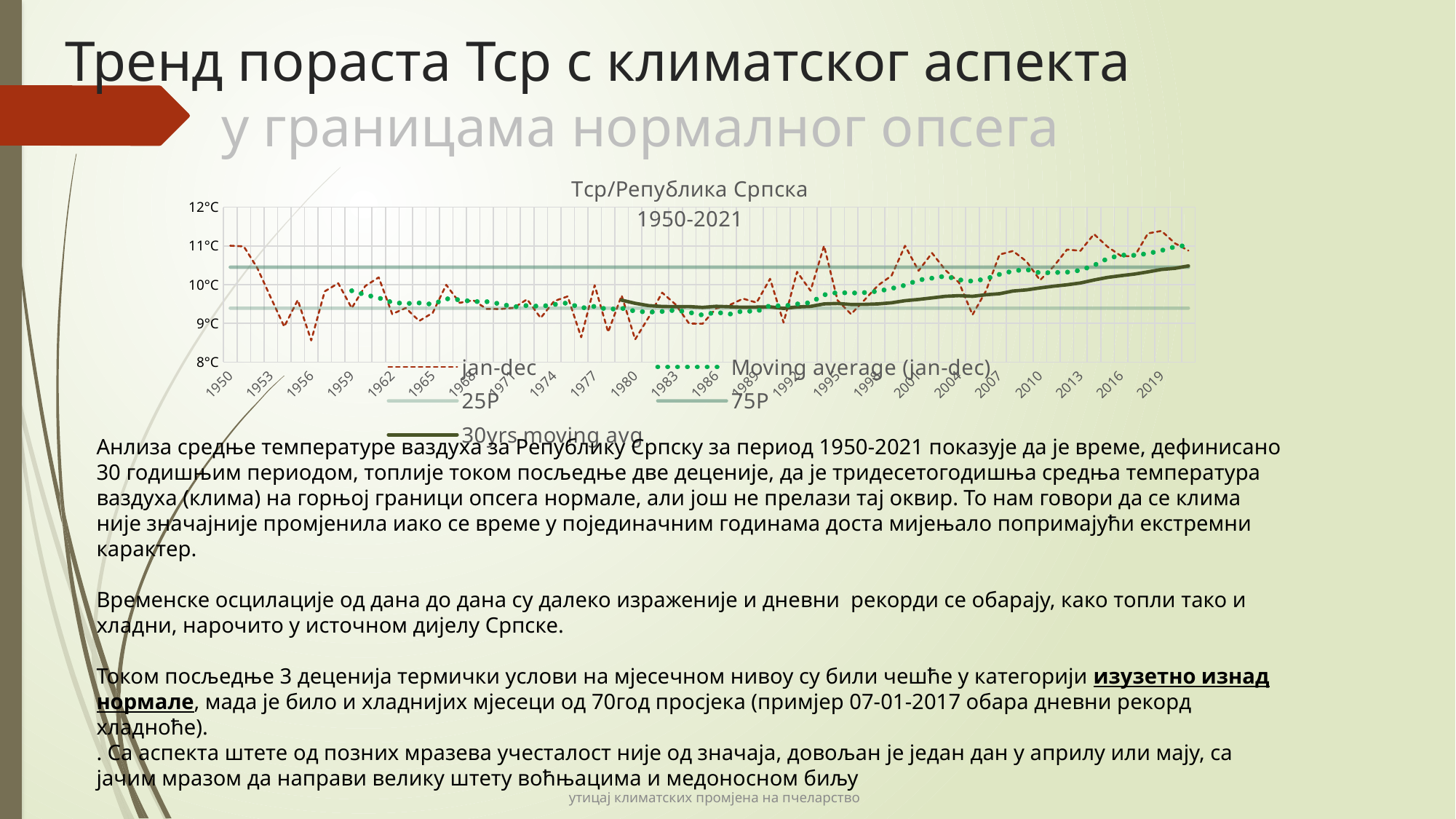
Is the jan-dec value around 1956 greater or less than 9°C? less Is the Moving average (jan-dec) value in 1980 greater or less than 10°C? less Is the 30yrs moving avg value in 2019 greater or less than 10°C? greater What is the title of the chart? Тср/Република Српска 1950-2021 What is the highest value shown on the y axis? 12°C How many series does the chart legend list? 5 Does the Moving average (jan-dec) line generally rise or fall from 1990 to 2021? rises What kind of chart is shown on the slide? line chart Which legend entry is drawn as a green dotted line? Moving average (jan-dec) Does the 30yrs moving avg line rise or fall from 1980 to 2021? rises